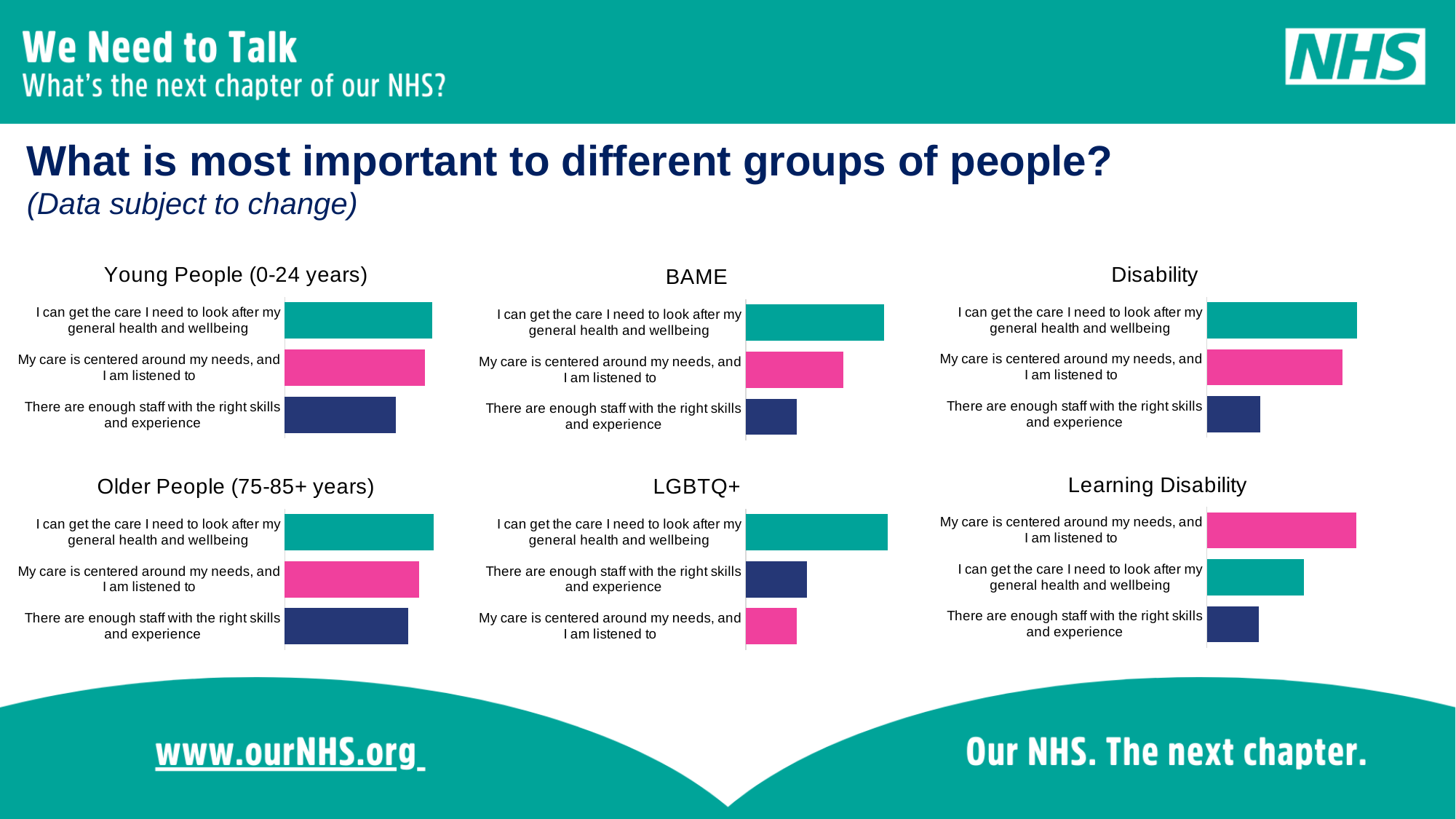
In the LGBTQ+ chart, which category has the longest bar? I can get the care I need to look after my general health and wellbeing In the Learning Disability chart, what kind of chart is used? Bar chart In the BAME chart, how many categories are plotted? 3 In the Disability chart, which category has the shortest bar? There are enough staff with the right skills and experience In the Learning Disability chart, which is larger: 'I can get the care I need to look after my general health and wellbeing' or 'There are enough staff with the right skills and experience'? I can get the care I need to look after my general health and wellbeing In the Learning Disability chart, which category has the longest bar? My care is centered around my needs, and I am listened to In the BAME chart, which category has the shortest bar? There are enough staff with the right skills and experience How many charts are shown on the slide? 6 In the Disability chart, what colour is the bar for 'There are enough staff with the right skills and experience'? Dark blue In the BAME chart, which is larger: 'My care is centered around my needs, and I am listened to' or 'There are enough staff with the right skills and experience'? My care is centered around my needs, and I am listened to In the Young People (0-24 years) chart, which category has the shortest bar? There are enough staff with the right skills and experience In the Older People (75-85+ years) chart, which is larger: 'I can get the care I need to look after my general health and wellbeing' or 'There are enough staff with the right skills and experience'? I can get the care I need to look after my general health and wellbeing